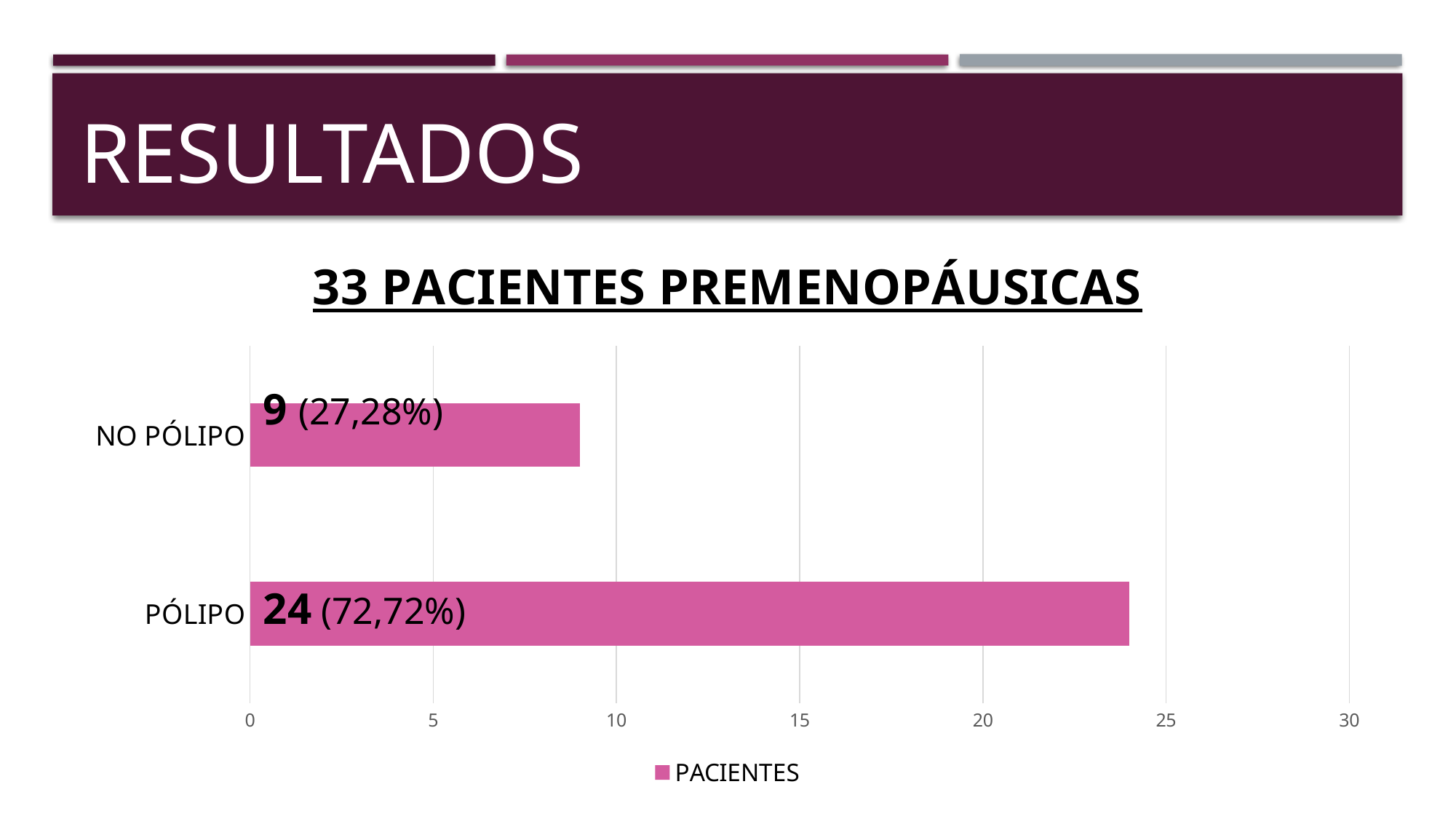
What is the difference between the values for PÓLIPO and NO PÓLIPO? 15 What kind of chart is shown on the slide? bar chart Which category has the lowest value? NO PÓLIPO What is the value for PÓLIPO? 24 What is the value for NO PÓLIPO? 9 What percentage is shown next to the PÓLIPO bar? 72,72% What percentage is shown next to the NO PÓLIPO bar? 27,28% Which is larger, the value for PÓLIPO or NO PÓLIPO? PÓLIPO Which category has the highest value? PÓLIPO Is the value for PÓLIPO greater or less than 20? greater What series name does the legend show? PACIENTES How many categories are shown in the chart? 2